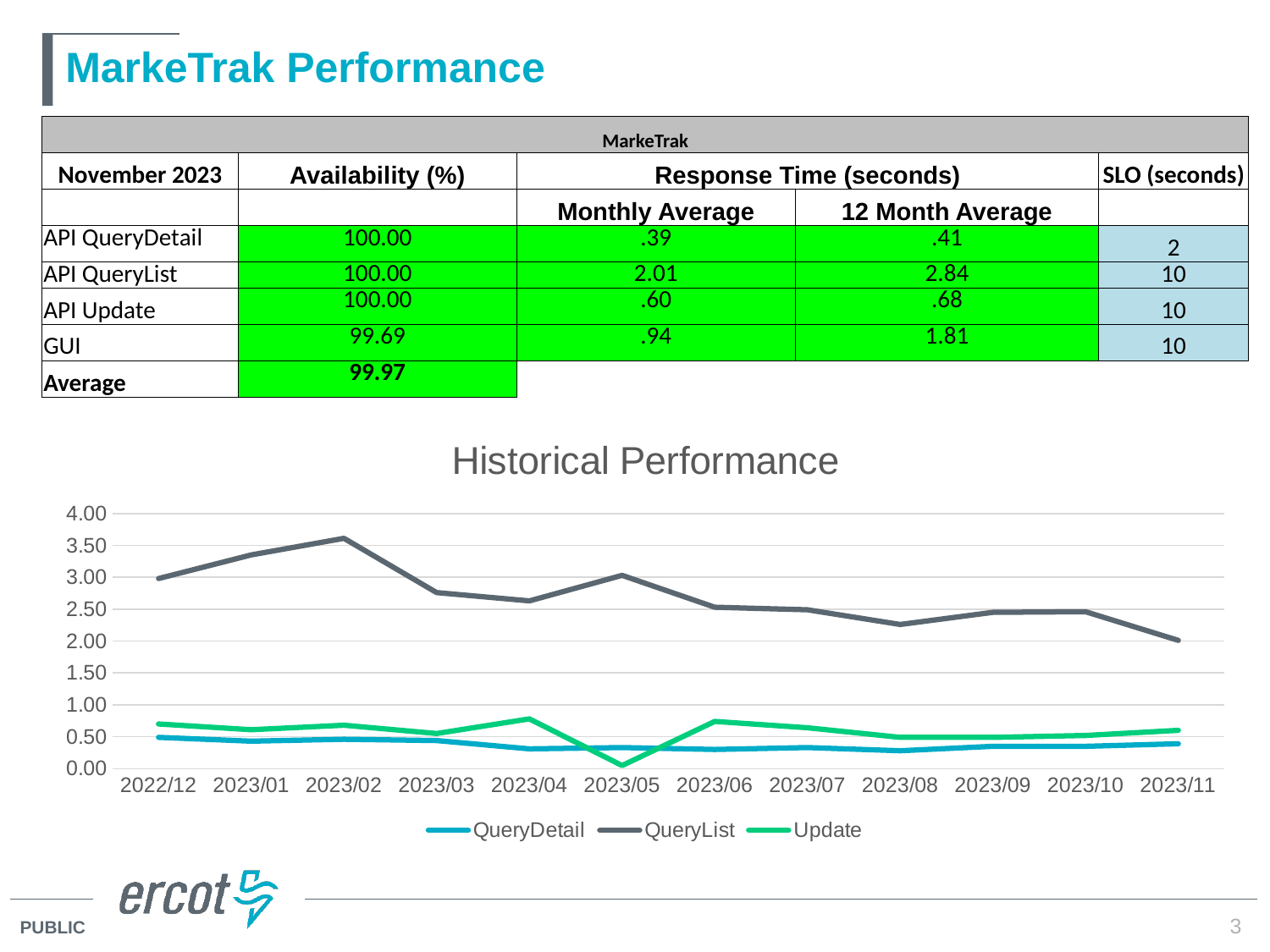
In the Historical Performance chart, which series has the highest values throughout the period? QueryList What is the title of the line chart on the slide? Historical Performance In the Historical Performance chart, in which month does the QueryList series reach its highest value? 2023/02 In the Historical Performance chart, is the Update value for 2023/05 greater or less than 0.50? less In the Historical Performance chart, is the QueryList value for 2023/02 greater or less than 3.50? greater What kind of chart is the Historical Performance chart? line chart How many months are plotted along the x axis of the Historical Performance chart? 12 In the Historical Performance chart, does the QueryList series overall rise or fall from 2023/02 to 2023/11? fall In the Historical Performance chart, is the QueryList value for 2023/08 greater or less than 2.50? less In the Historical Performance chart, which series is larger at 2023/06, QueryList or Update? QueryList How many series does the legend of the Historical Performance chart list? 3 In the Historical Performance chart, in which month does the Update series reach its lowest value? 2023/05